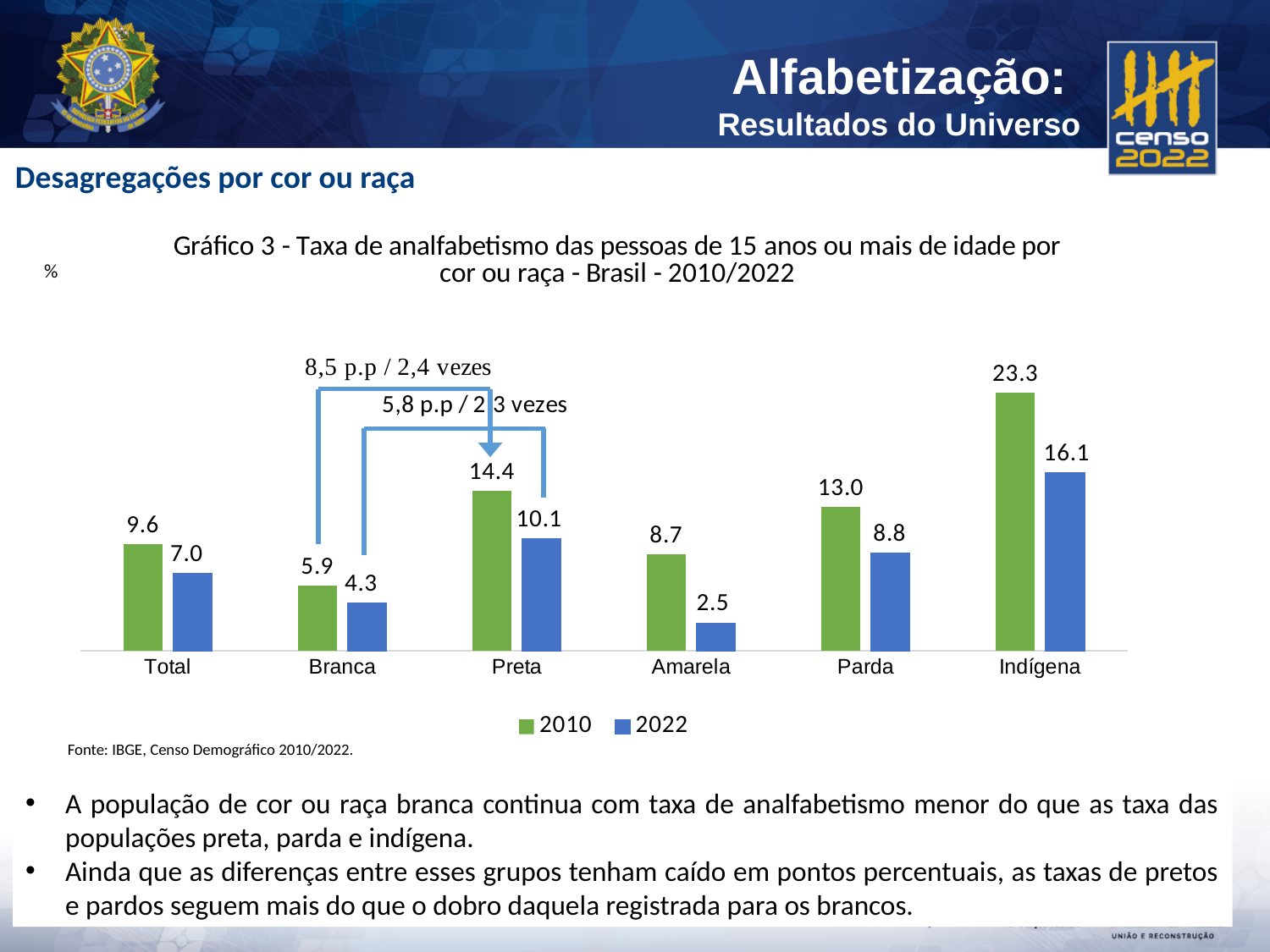
Which category has the lowest value in the 2010 series? Branca Which is larger: the 2022 value for Parda or the 2022 value for Preta? Preta What is the difference between the 2010 and 2022 values for the Preta category? 4.3 What is the 2022 value for the Total category? 7.0 What kind of chart is shown on the slide? Bar chart What is the 2022 value for the Branca category? 4.3 How many series does the legend list? 2 What is the 2010 illiteracy rate for the Indígena category? 23.3 What is the difference between the 2010 and 2022 values for the Indígena category? 7.2 How many categories are shown on the x axis? 6 Which category has the lowest value in the 2022 series? Amarela Which category has the highest value in the 2022 series? Indígena